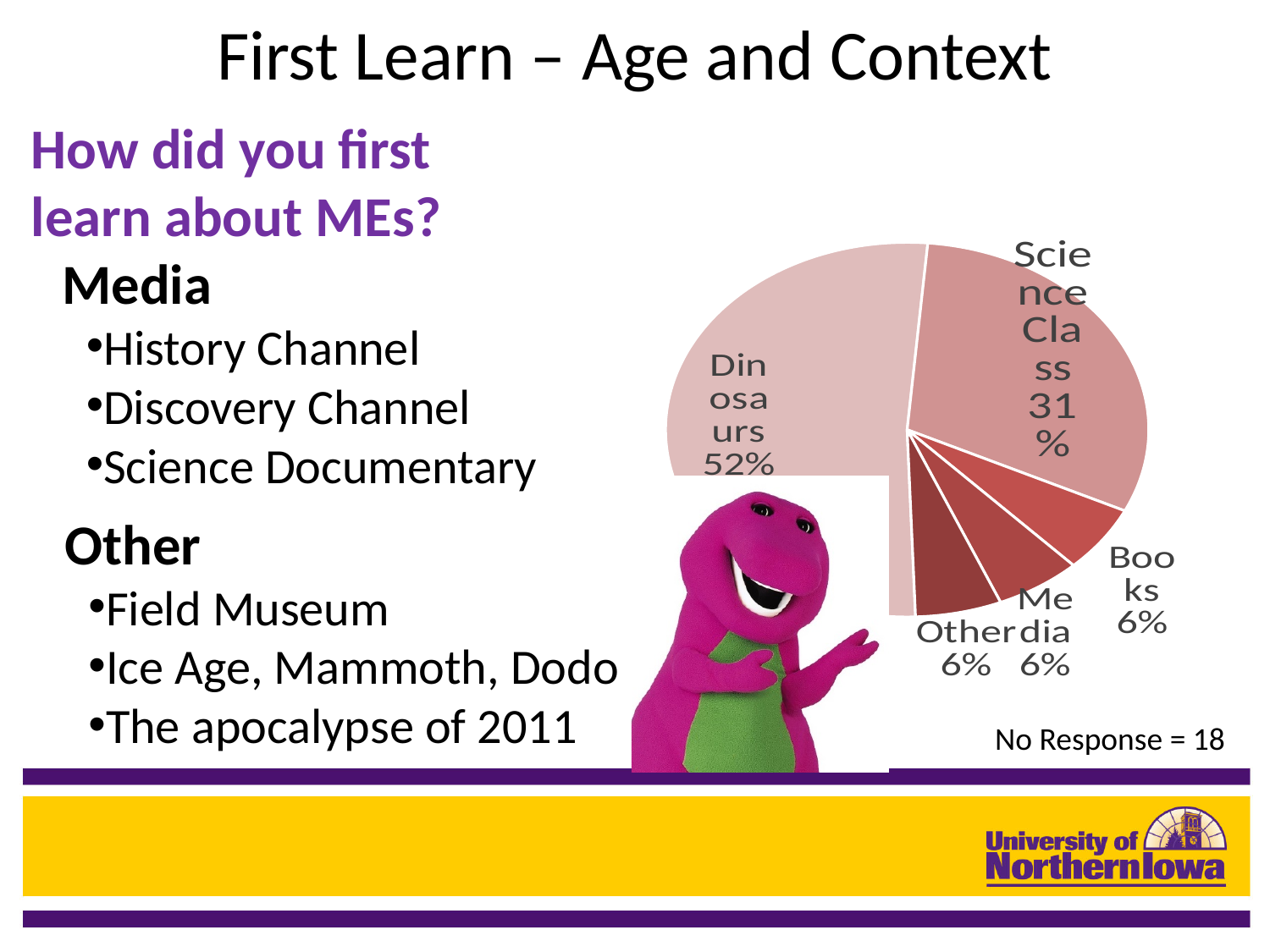
Which slice of the pie chart is the largest? Dinosaurs What share of the pie chart is labelled Other? 6% What share of the pie chart is labelled Science Class? 31% What share of the pie chart is labelled Dinosaurs? 52% According to the note below the pie chart, how many respondents gave no response? 18 How many slices does the pie chart have? 5 What kind of chart is shown on the slide? pie chart Which is larger in the pie chart, Science Class or Books? Science Class What is the combined share of the Dinosaurs and Science Class slices? 83% What is the difference in percentage points between the Dinosaurs slice and the Science Class slice? 21